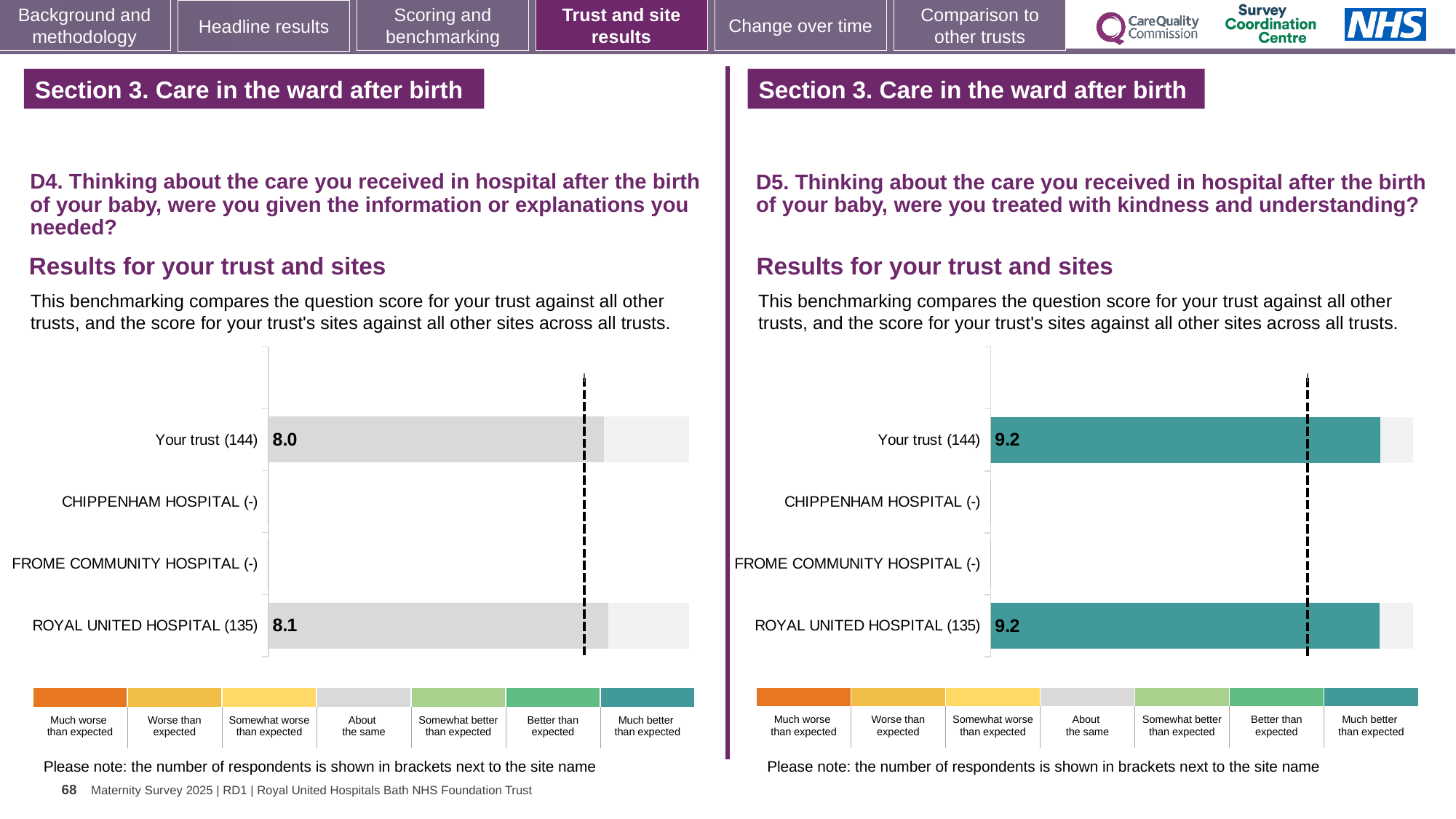
How many benchmark categories does the colour legend below the D4 chart on the left list? 7 How many site or trust rows are listed on the y axis of the D4 chart on the left? 4 In the D4 chart on the left, what is the difference between the ROYAL UNITED HOSPITAL score and the Your trust score? 0.1 In the D4 chart on the left, what is the score for ROYAL UNITED HOSPITAL? 8.1 In the D5 chart on the right, what is the score for Your trust? 9.2 In the D5 chart on the right, what is the difference between the Your trust score and the ROYAL UNITED HOSPITAL score? 0.0 In the D5 chart on the right, which benchmark category does the colour of the Your trust bar correspond to in the legend? Much better than expected What type of chart is used for the D5 results on the right? Bar chart In the D4 chart on the left, how many respondents are shown in brackets for Your trust? 144 In the D5 chart on the right, what is the score for ROYAL UNITED HOSPITAL? 9.2 In the D4 chart on the left, what is the score for Your trust? 8.0 In the D5 chart on the right, how many respondents are shown in brackets for ROYAL UNITED HOSPITAL? 135